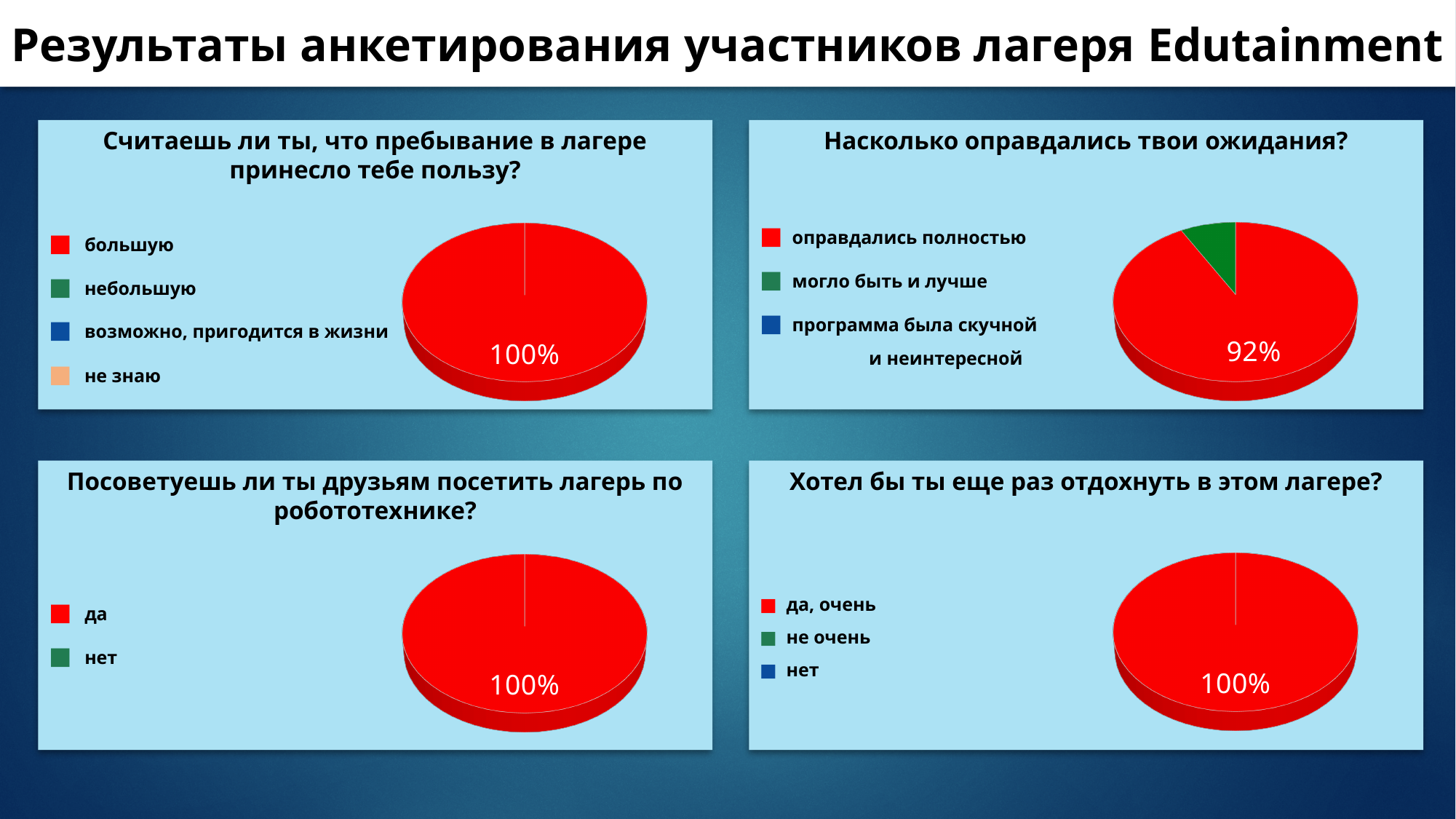
What kind of chart is used in the top-left panel of the slide? Pie chart In the chart titled "Насколько оправдались твои ожидания?", what colour represents "могло быть и лучше"? Green How many answer options does the legend list in the chart titled "Посоветуешь ли ты друзьям посетить лагерь по робототехнике?"? 2 How many answer options does the legend list in the chart titled "Считаешь ли ты, что пребывание в лагере принесло тебе пользу?"? 4 In the chart titled "Насколько оправдались твои ожидания?", what share is shown for "оправдались полностью"? 92% How many answer options does the legend list in the chart titled "Хотел бы ты еще раз отдохнуть в этом лагере?"? 3 In the chart titled "Насколько оправдались твои ожидания?", which answer has the largest slice? оправдались полностью How many pie charts are shown on the slide? 4 In the chart titled "Посоветуешь ли ты друзьям посетить лагерь по робототехнике?", what share is shown for "да"? 100% In the chart titled "Насколько оправдались твои ожидания?", which slice is larger: "оправдались полностью" or "могло быть и лучше"? оправдались полностью In the chart titled "Считаешь ли ты, что пребывание в лагере принесло тебе пользу?", what share is shown for "большую"? 100% In the chart titled "Хотел бы ты еще раз отдохнуть в этом лагере?", what share is shown for "да, очень"? 100%